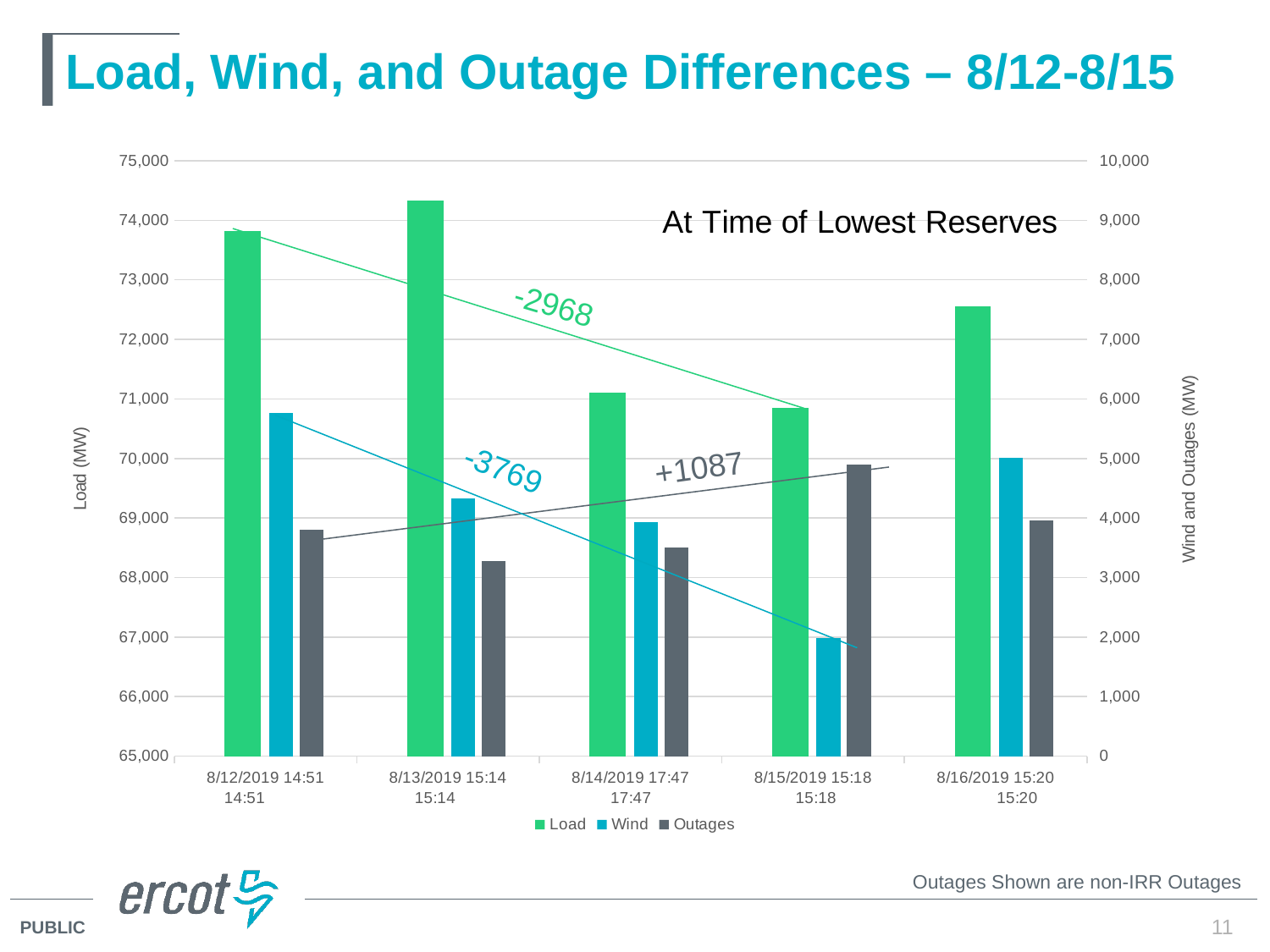
On which date is the Load bar highest? 8/13/2019 15:14 How many date/time categories are shown on the x axis? 5 Is the Load value for 8/13/2019 15:14 greater or less than 74,000? greater Does the Wind series rise or fall from 8/12/2019 to 8/15/2019? fall On which date is the Wind bar lowest? 8/15/2019 15:18 What change in Load between 8/12/2019 and 8/15/2019 is annotated on the chart? -2968 What change in Wind between 8/12/2019 and 8/15/2019 is annotated on the chart? -3769 What change in Outages between 8/12/2019 and 8/15/2019 is annotated on the chart? +1087 How many series does the legend list? 3 On which date is the Outages bar highest? 8/15/2019 15:18 What kind of chart is shown on the slide? bar chart What is the label of the right-hand vertical axis? Wind and Outages (MW)